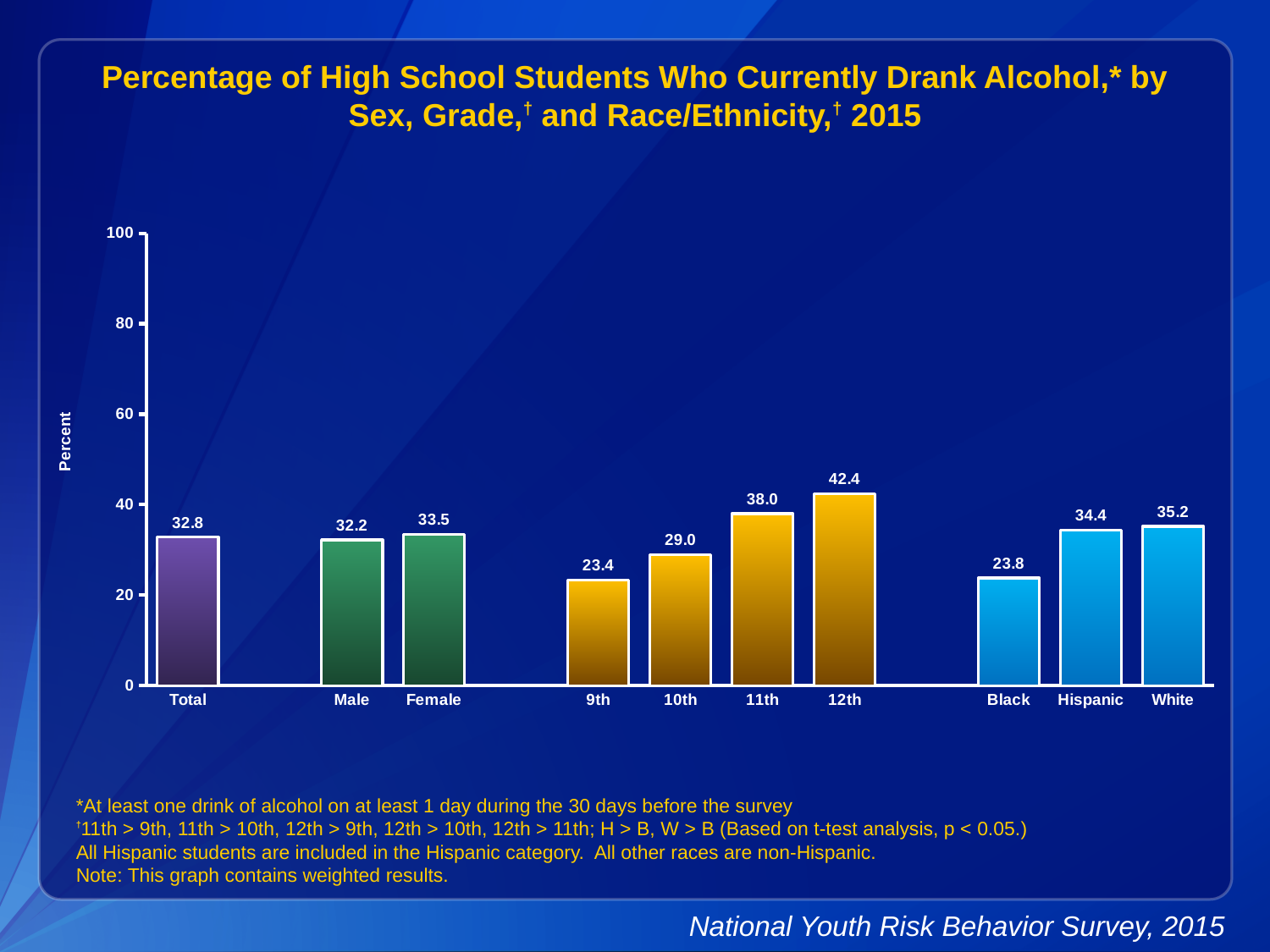
What is the difference between the values for Female and Male? 1.3 Is the value for 11th grade greater or less than 40? less Which is larger, the value for White or the value for Black? White What is the value for Total? 32.8 What is the value for Hispanic students? 34.4 What is the difference between the values for 12th and 9th grade? 19.0 How many bars are shown in the chart? 10 Do the values rise or fall from 9th grade to 12th grade? rise What is the value for 12th grade students? 42.4 Which category has the highest value? 12th Which category has the lowest value? 9th What kind of chart is shown on the slide? bar chart